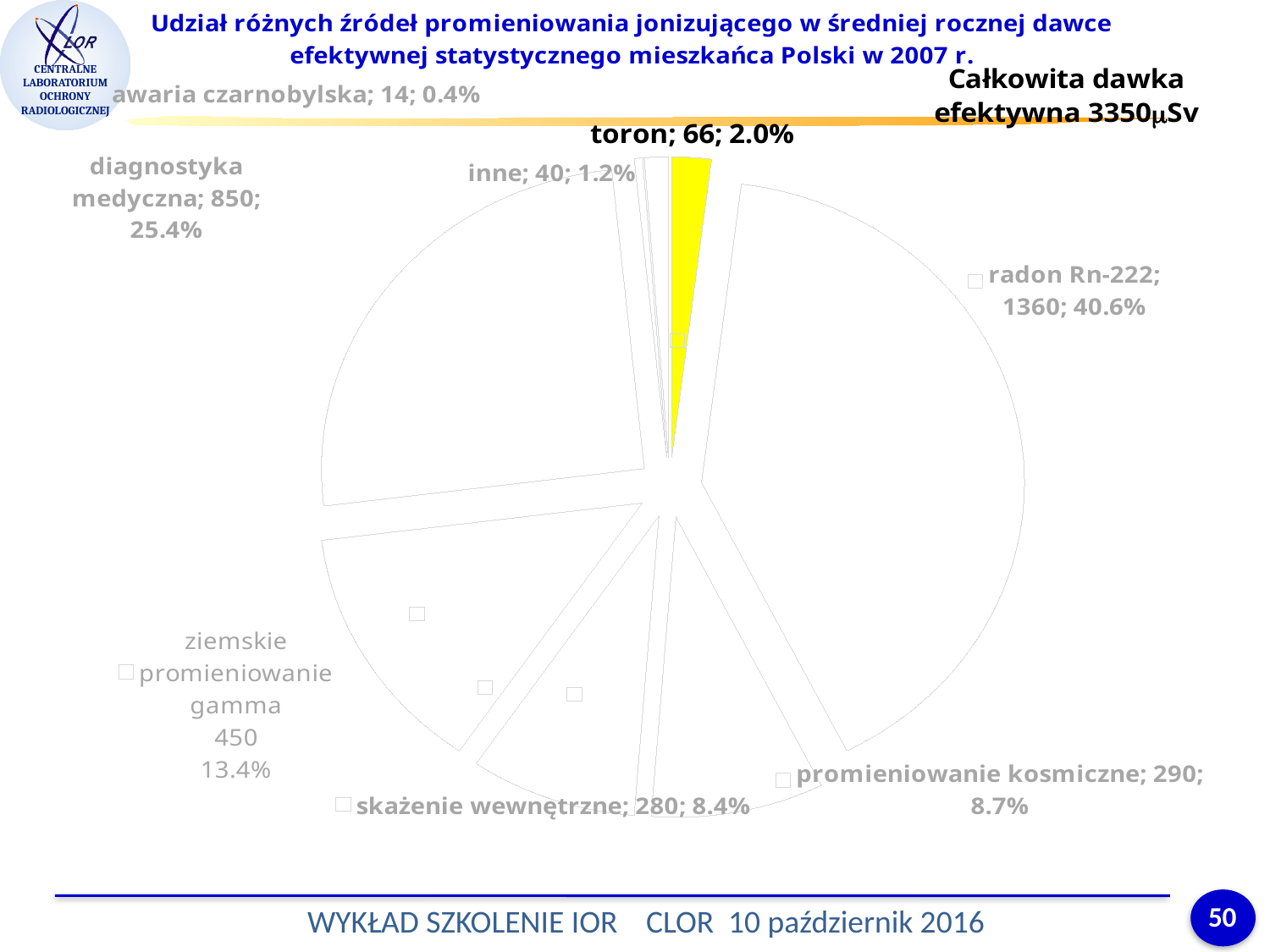
Which is larger, the value for promieniowanie kosmiczne or skażenie wewnętrzne? promieniowanie kosmiczne Which source has the largest share of the pie? radon Rn-222 Which slice of the pie is highlighted in yellow? toron What percentage share is shown for diagnostyka medyczna? 25.4% How many slices does the pie chart have? 8 What value is shown for radon Rn-222? 1360 What kind of chart is shown on the slide? pie chart What value is shown for promieniowanie kosmiczne? 290 What percentage share is shown for toron? 2.0% What total effective dose is stated on the slide? 3350 µSv Which source has the smallest share of the pie? awaria czarnobylska What is the difference between the values for radon Rn-222 and diagnostyka medyczna? 510